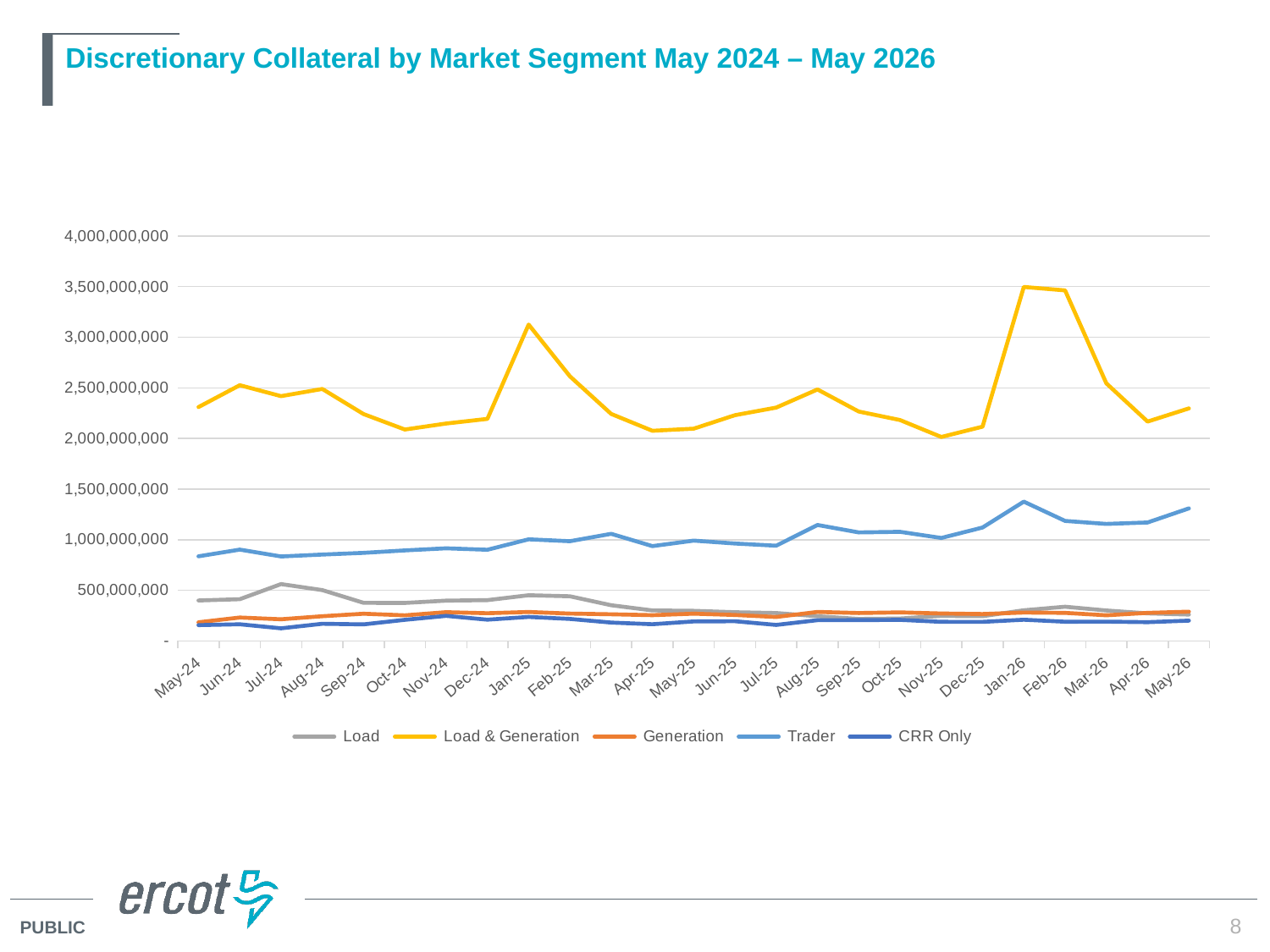
How many series does the legend list? 5 Is the value for Trader in May-24 greater or less than 1,000,000,000? less How many months are plotted along the x axis? 25 Is the value for Load in Jul-24 greater or less than 500,000,000? greater Is the value for Trader in Jan-26 greater or less than 1,000,000,000? greater What kind of chart is shown on the slide? line chart Which market segment has the highest discretionary collateral across the whole period? Load & Generation Does the Load & Generation series rise or fall from Jan-26 to Apr-26? fall Which market segment has the lowest discretionary collateral across the whole period? CRR Only In which month does the Trader series reach its highest value? Jan-26 In May-26, which is larger: Trader or Load? Trader